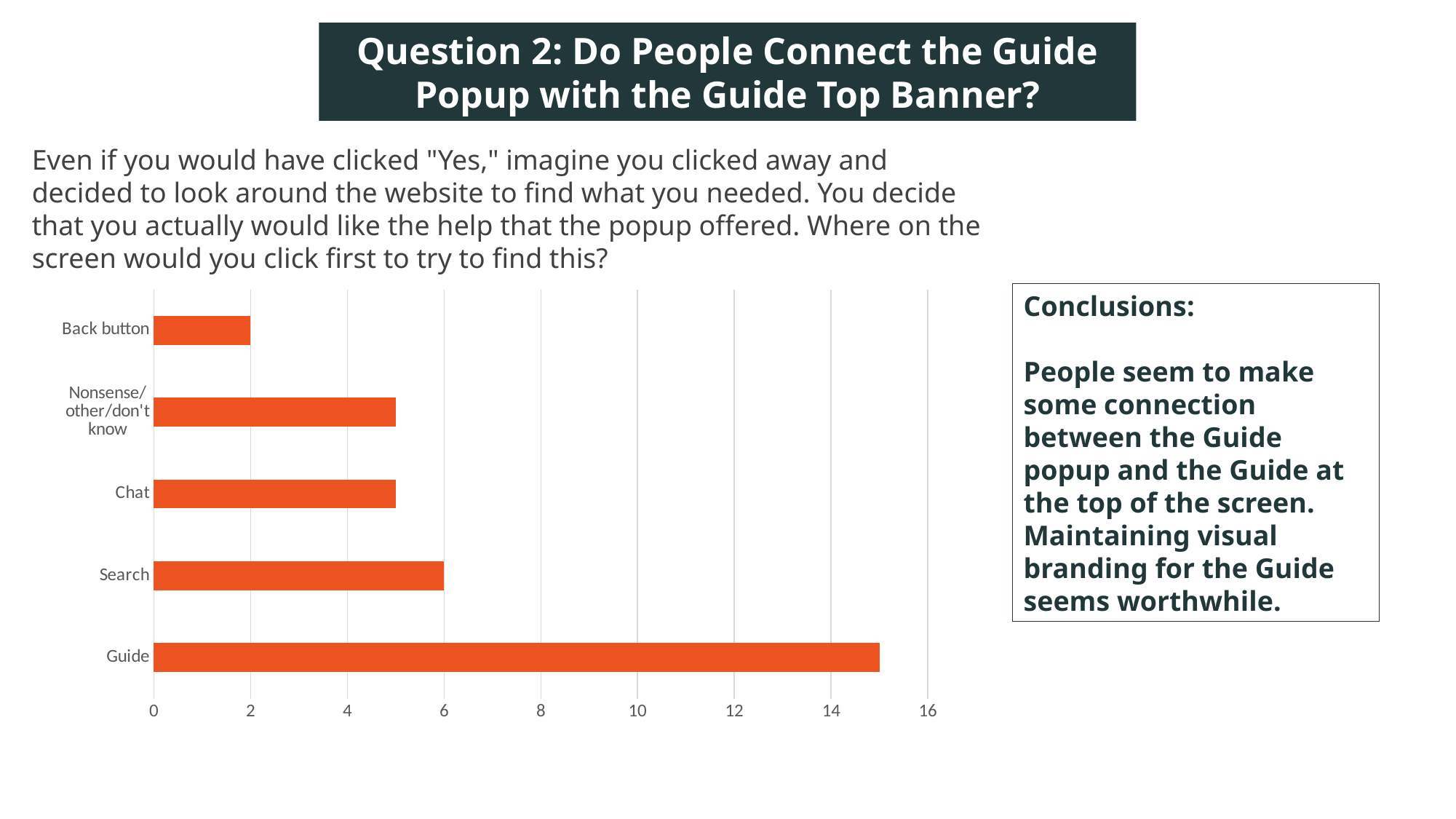
Is the value for Guide greater or less than 14? greater How many categories are shown in the bar chart? 5 Is the value for Nonsense/other/don't know greater or less than 6? less What kind of chart is shown on the slide? bar chart What is the value for Search? 6 Which is larger, the value for Guide or the value for Search? Guide Is the value for Chat greater or less than 4? greater What is the value for Back button? 2 What colour are the bars in the chart? orange What is the difference between the values for Search and Back button? 4 Which category has the lowest value in the bar chart? Back button Which category has the highest value in the bar chart? Guide